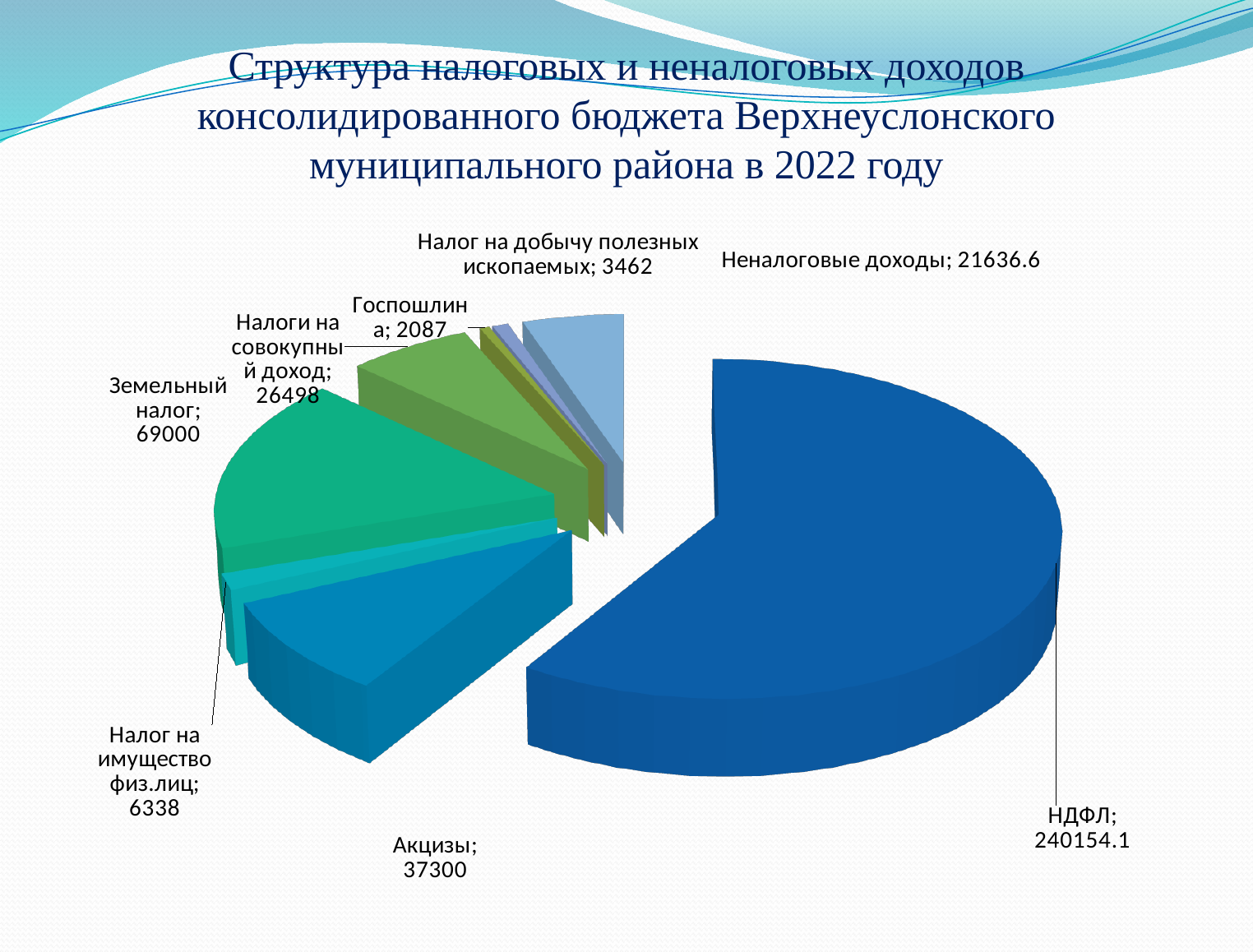
Which category has the smallest value? Госпошлина What type of chart is shown on the slide? Pie chart What is the value for НДФЛ? 240154.1 What is the value for Госпошлина? 2087 How many categories (slices) does the pie chart have? 8 What is the value for Неналоговые доходы? 21636.6 Which is larger, Акцизы or Налоги на совокупный доход? Акцизы What is the difference between Земельный налог and Акцизы? 31700 What is the value for Налог на добычу полезных ископаемых? 3462 Which category has the largest value? НДФЛ What is the value for Земельный налог? 69000 What year does the chart title refer to? 2022